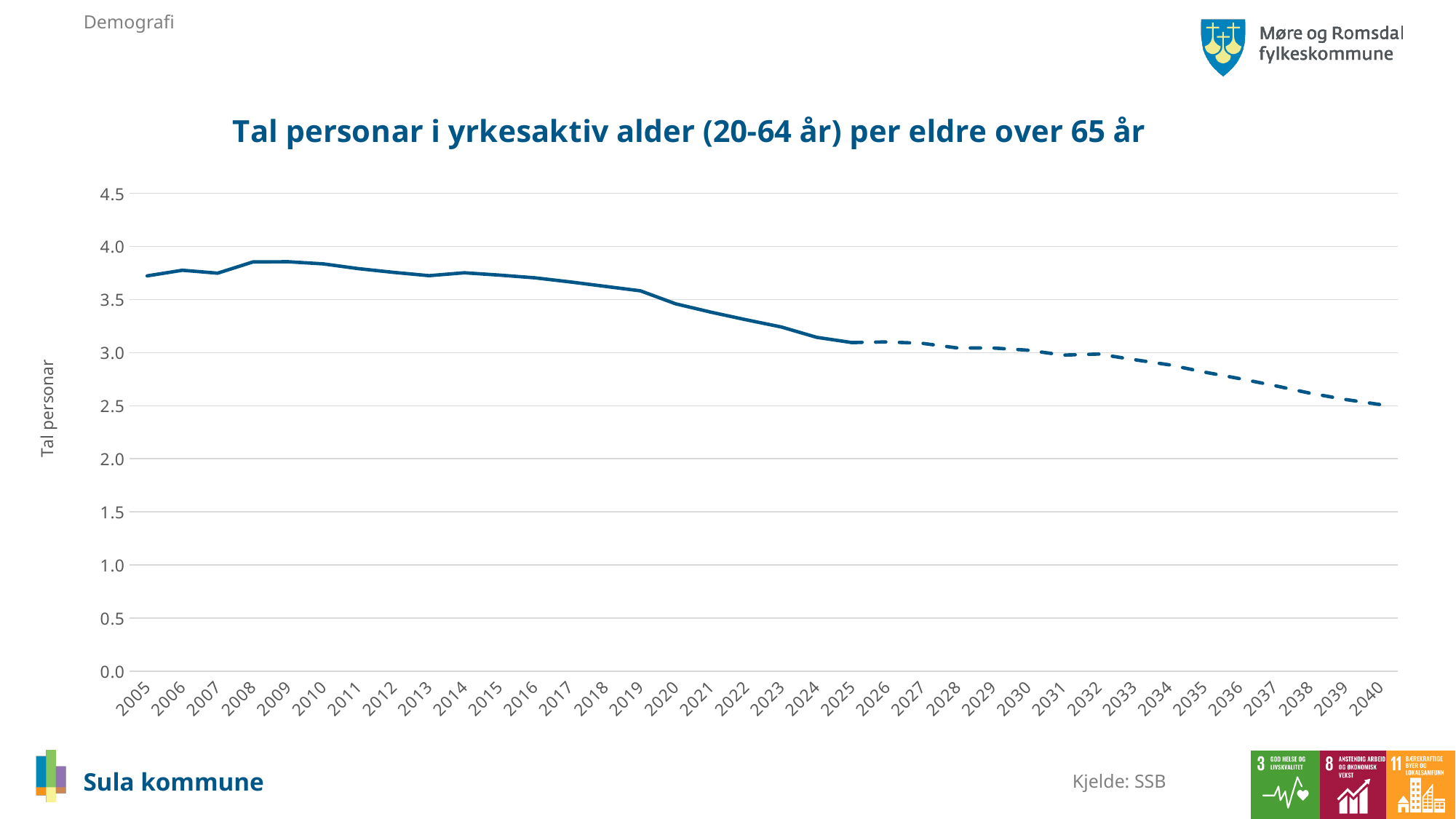
Which year has the lowest value in the chart? 2040 Is the value for 2005 greater or less than 3.5? greater Is the value for 2008 greater or less than 4.0? less What is the label on the vertical axis of the chart? Tal personar Is the value for 2035 greater or less than 3.0? less Which year has the larger value, 2019 or 2020? 2019 Which year has the larger value, 2005 or 2040? 2005 What kind of chart is shown on the slide? line chart Does the value generally rise or fall from 2005 to 2040? fall How many years are shown along the x axis of the chart? 36 What is the title of the chart? Tal personar i yrkesaktiv alder (20-64 år) per eldre over 65 år